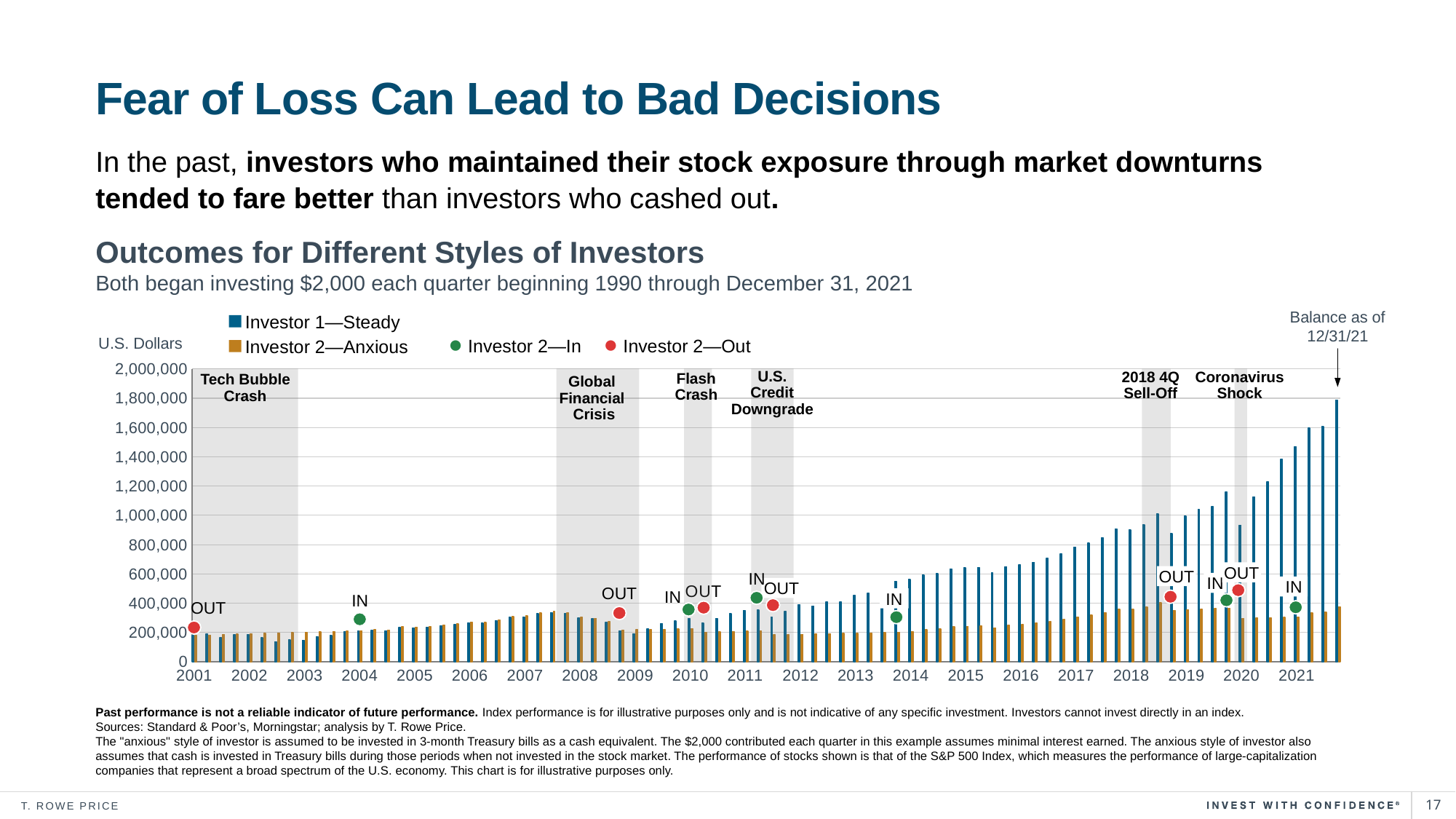
What kind of chart is shown on the slide? Bar chart Does the balance for Investor 1—Steady generally rise or fall from 2001 to 2021? Rise What unit is shown on the y axis of the chart? U.S. Dollars Is the final balance for Investor 1—Steady at the end of 2021 greater or less than 1,600,000? greater Which investor has the larger balance at the end of 2021, Investor 1—Steady or Investor 2—Anxious? Investor 1—Steady How many years are labelled on the x axis of the chart? 21 Is the balance for Investor 2—Anxious in 2010 greater or less than 400,000? less In which year does Investor 1—Steady reach its highest balance? 2021 Is the balance for Investor 1—Steady at the end of 2016 greater or less than 600,000? greater What is the title of the chart? Outcomes for Different Styles of Investors How many entries does the chart legend list? 4